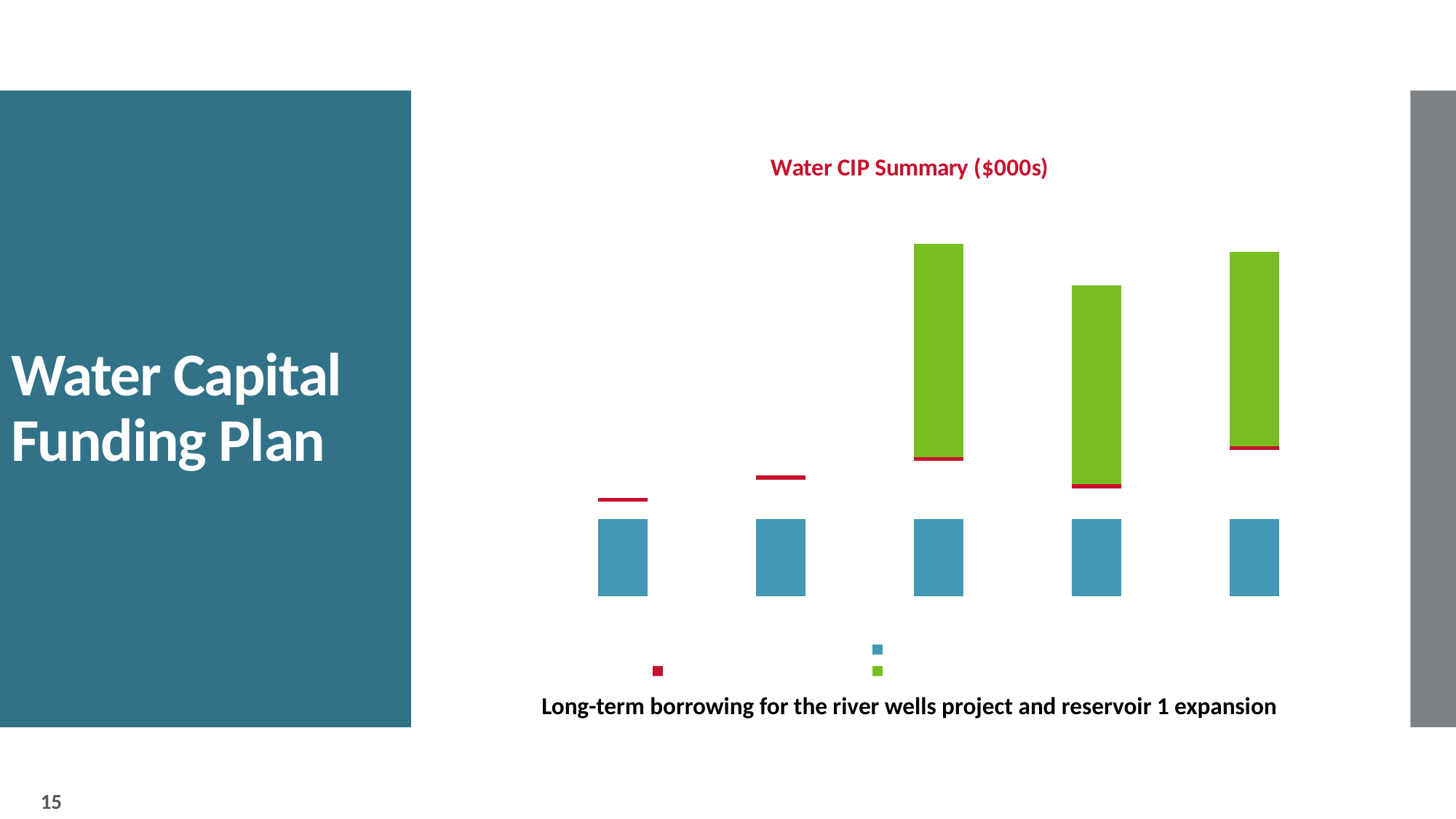
How many bars are plotted in the chart? 5 How many of the bars include a green segment? 3 Is the second bar from the left taller or shorter than the fourth bar from the left? Shorter What kind of chart is shown on the slide? Stacked bar chart What colour is the bottom segment of every bar? Blue Is the first bar from the left taller or shorter than the third bar from the left? Shorter What is the title of the chart? Water CIP Summary ($000s)